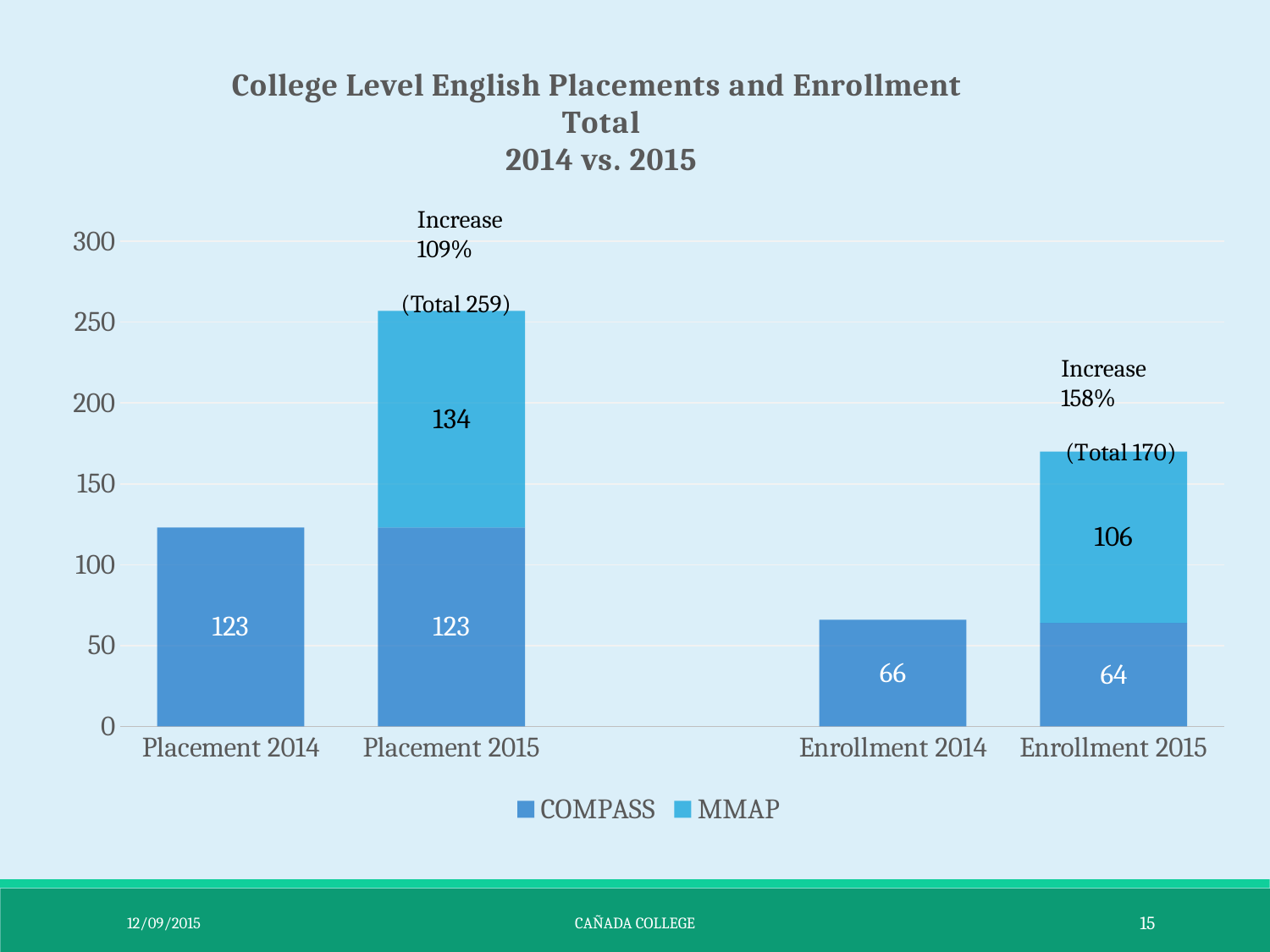
How many series does the legend list? 2 Which category has the lowest COMPASS value? Enrollment 2015 What is the MMAP value for Placement 2015? 134 What is the total of the stacked bar for Enrollment 2015? 170 What is the MMAP value for Enrollment 2015? 106 What kind of chart is shown on the slide? Stacked bar chart What is the total of the stacked bar for Placement 2015? 259 Which is larger, the COMPASS value for Enrollment 2014 or the COMPASS value for Enrollment 2015? Enrollment 2014 What is the COMPASS value for Placement 2014? 123 What percentage increase is annotated above the Enrollment 2015 bar? 158% What is the COMPASS value for Enrollment 2015? 64 What is the difference between the MMAP value for Placement 2015 and the MMAP value for Enrollment 2015? 28